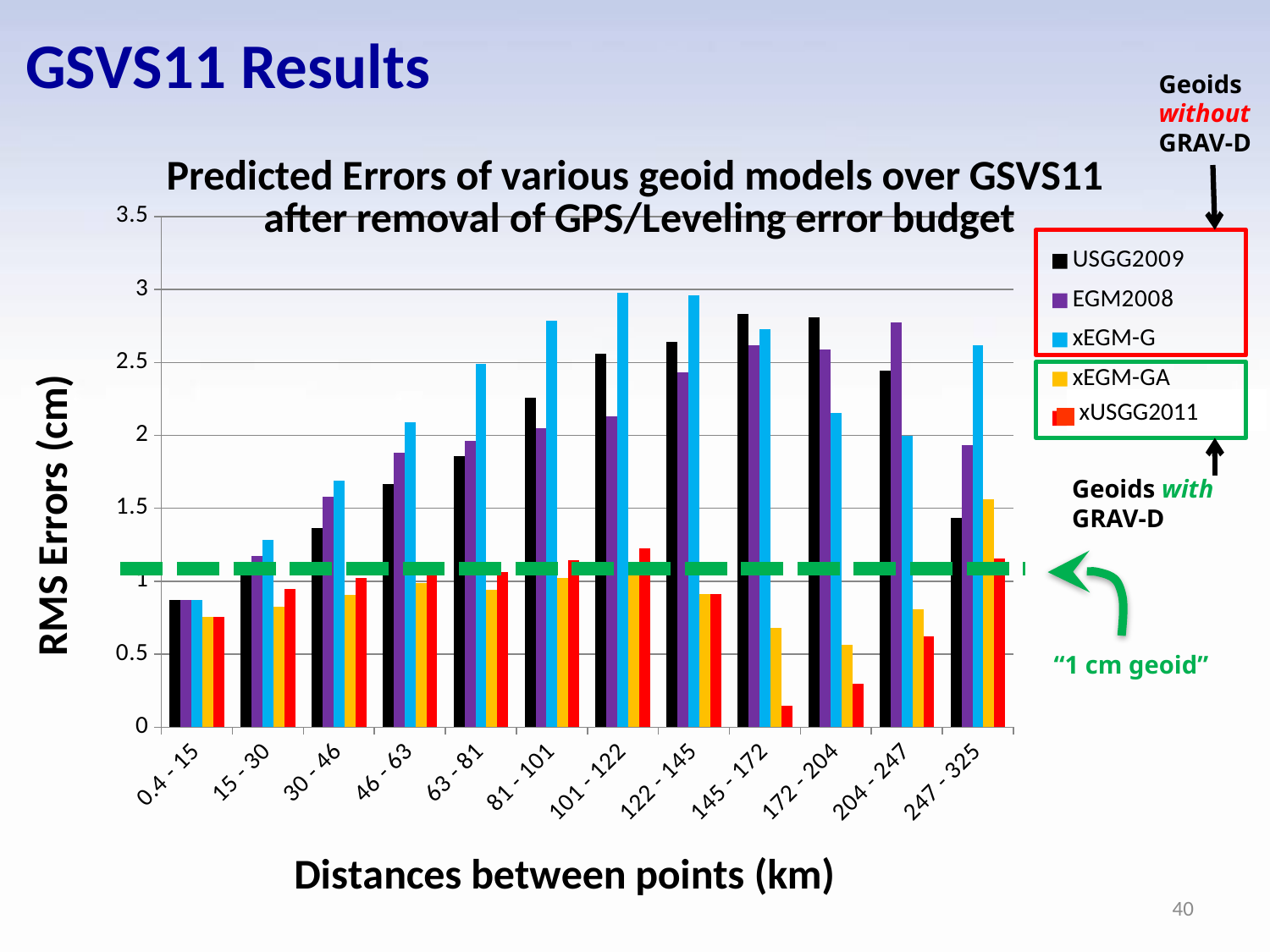
How many distance categories are shown on the x axis? 12 For which distance category is the xUSGG2011 value lowest? 145 - 172 For which distance category is the EGM2008 value highest? 204 - 247 Is the xEGM-G value for the 101 - 122 km category greater or less than 2.5? greater What is the label of the y axis? RMS Errors (cm) Is the xUSGG2011 value for the 172 - 204 km category greater or less than 0.5? less In the 247 - 325 km category, which is larger: the xEGM-G value or the USGG2009 value? xEGM-G How many series does the legend list? 5 What kind of chart is shown on the slide? bar chart Is the EGM2008 value for the 204 - 247 km category greater or less than 2.5? greater Do the xEGM-G values rise or fall from the 0.4 - 15 km category to the 101 - 122 km category? rise